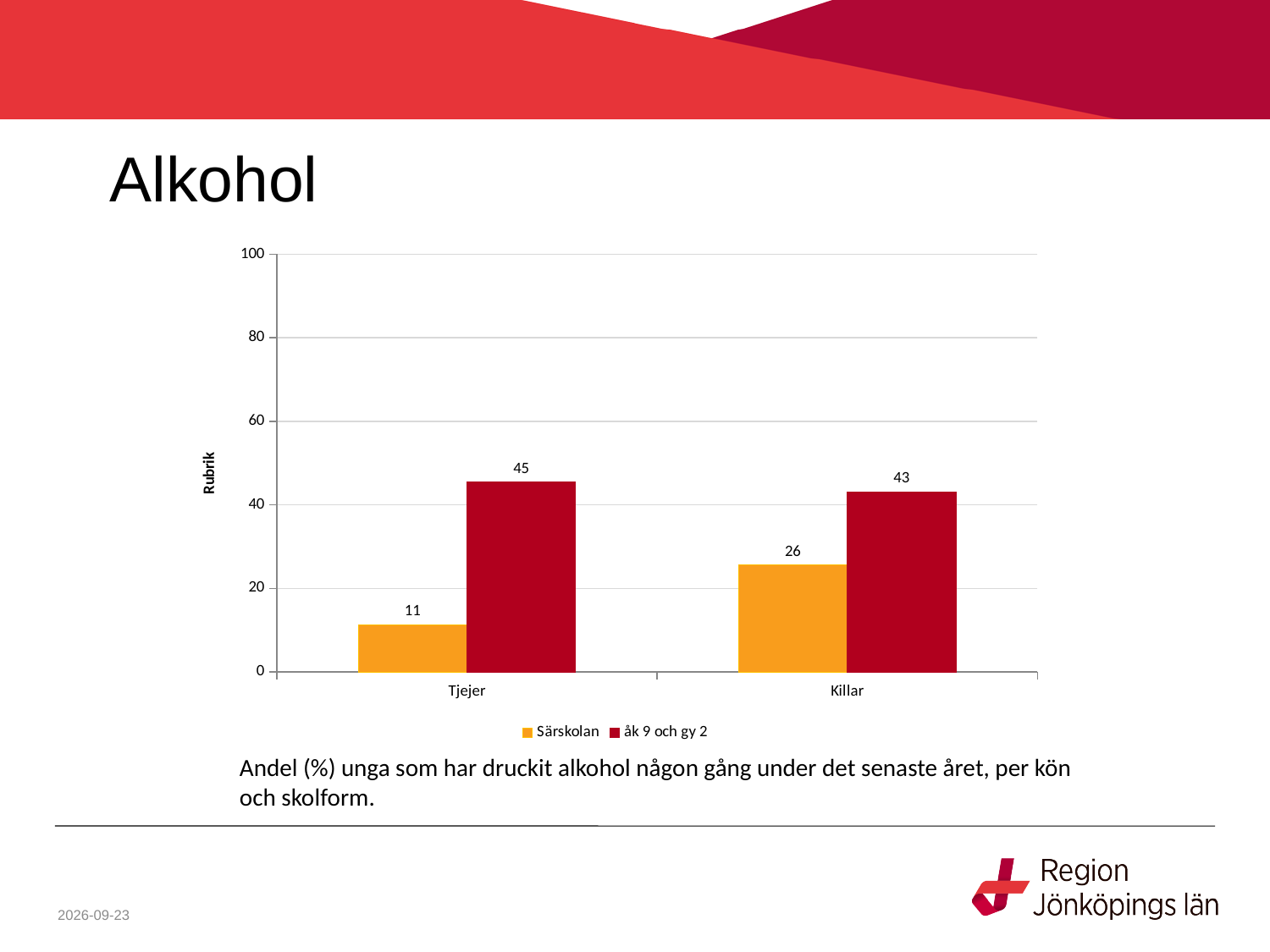
Which category has the highest value for Särskolan? Killar What is the value for åk 9 och gy 2 in the Tjejer category? 45 What kind of chart is shown on the slide? Bar chart What is the difference between the åk 9 och gy 2 value and the Särskolan value for Tjejer? 34 Which category has the lowest value for Särskolan? Tjejer What is the value for Särskolan in the Tjejer category? 11 What is the value for åk 9 och gy 2 in the Killar category? 43 How many series does the legend list? 2 Is the value for åk 9 och gy 2 in the Tjejer category greater or less than 40? greater Which is larger for Killar: Särskolan or åk 9 och gy 2? åk 9 och gy 2 What is the value for Särskolan in the Killar category? 26 What is the difference between the Särskolan values for Killar and Tjejer? 15